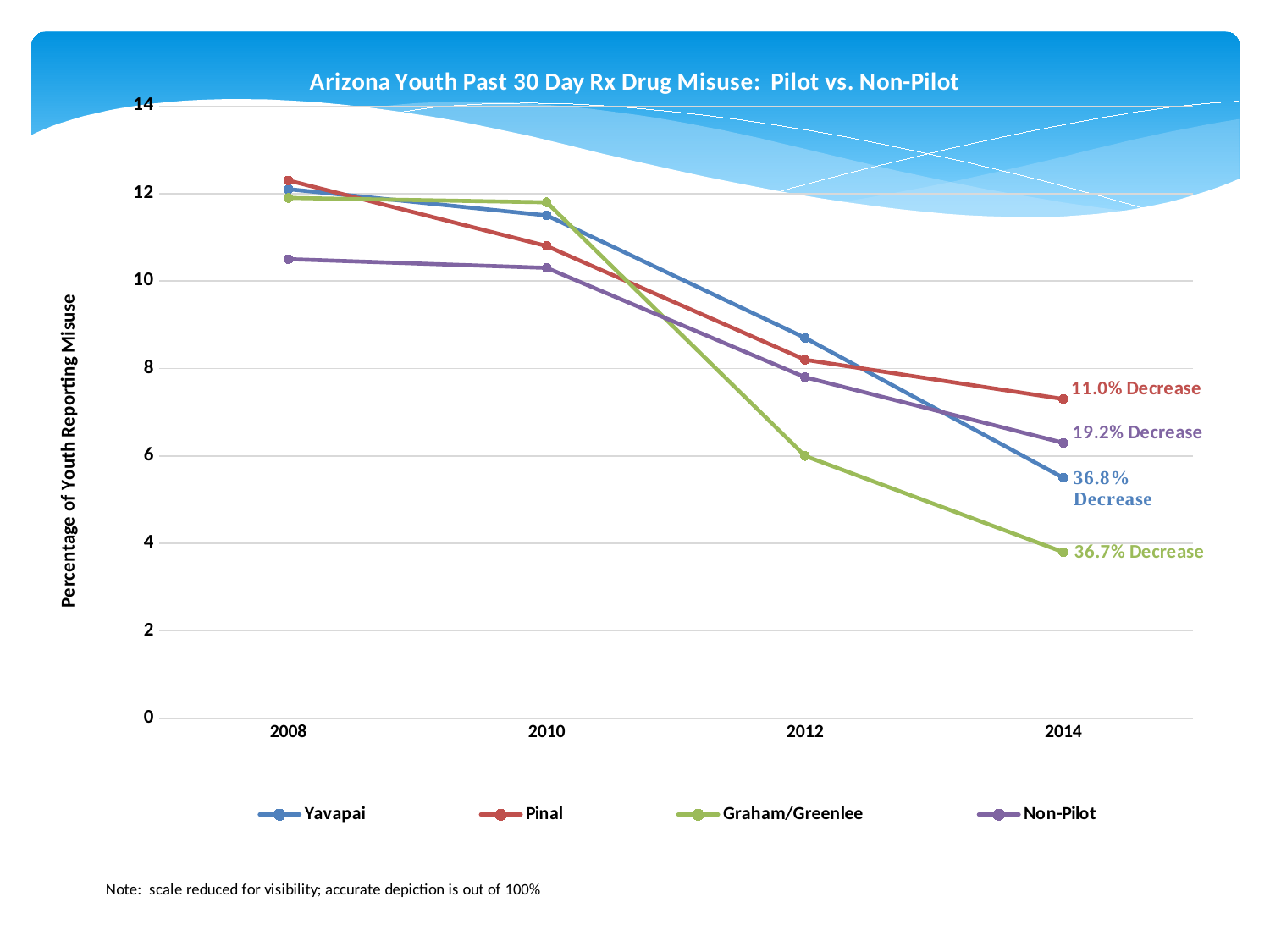
Is the value for Graham/Greenlee in 2014 greater or less than 6? less How many series does the legend list? 4 What percentage decrease is labelled for the Yavapai line? 36.8% Decrease Which series has the lowest value in 2014? Graham/Greenlee Which series has the lowest value in 2008? Non-Pilot Is the value for Graham/Greenlee in 2012 greater or less than 8? less How many years are shown on the x axis? 4 Is the value for Non-Pilot in 2008 greater or less than 10? greater What percentage decrease is labelled for the Pinal line? 11.0% Decrease Which series has the highest value in 2014? Pinal What kind of chart is shown on the slide? line chart Do the values for Graham/Greenlee rise or fall from 2008 to 2014? fall